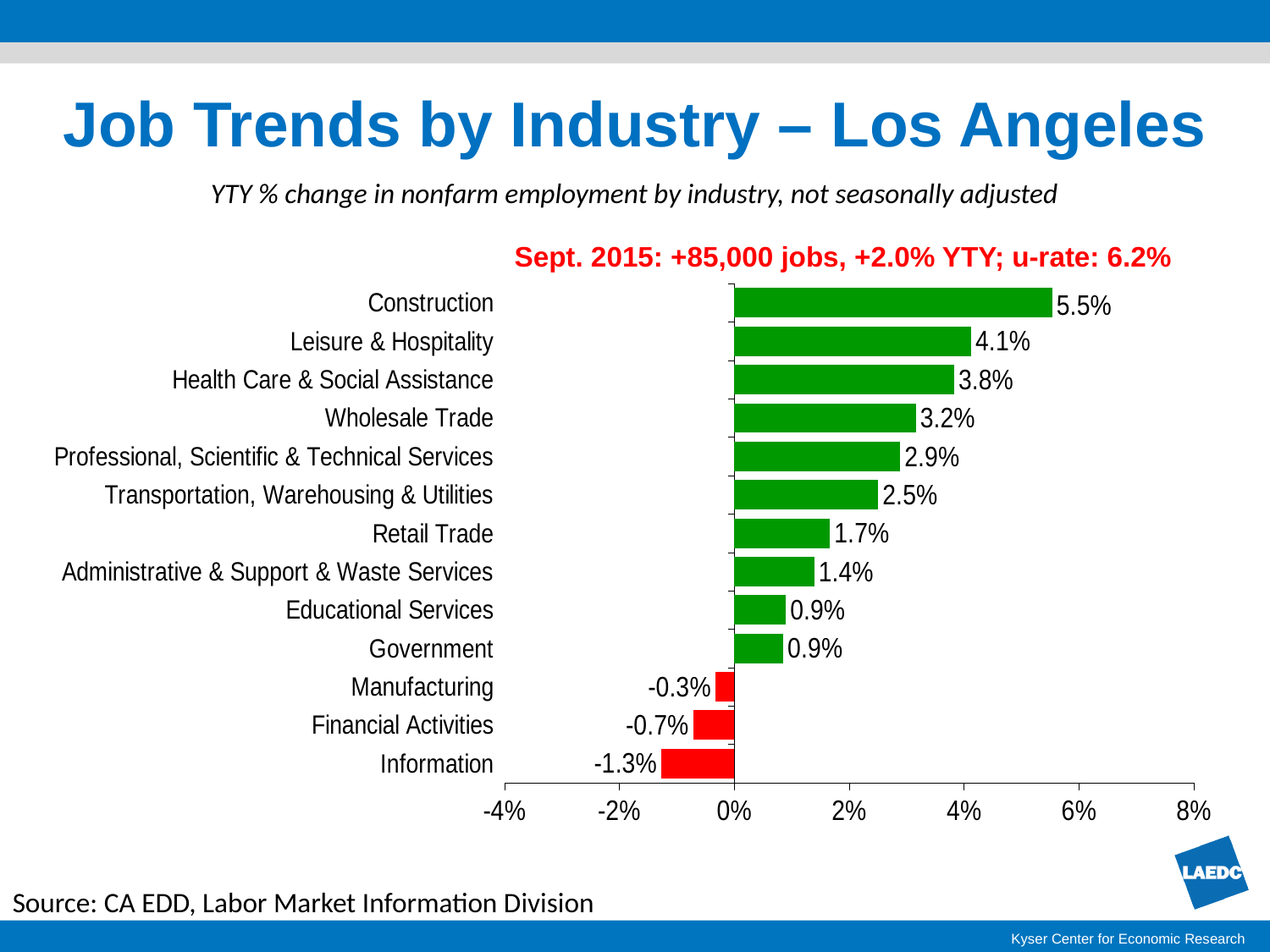
What kind of chart is shown on the slide? Bar chart Is the value for Construction greater or less than 4%? greater What is the YTY % change in employment for Wholesale Trade? 3.2% Which industry has the highest YTY % change in employment? Construction What is the YTY % change in employment for Information? -1.3% What colour are the bars for industries with negative YTY % change? Red How many industries show a negative YTY % change in employment? 3 What is the YTY % change in employment for Construction? 5.5% Which industry has the lowest YTY % change in employment? Information Which has a larger YTY % change in employment, Retail Trade or Health Care & Social Assistance? Health Care & Social Assistance How many industries are shown in the chart? 13 What is the difference between the YTY % change for Construction and Leisure & Hospitality? 1.4%